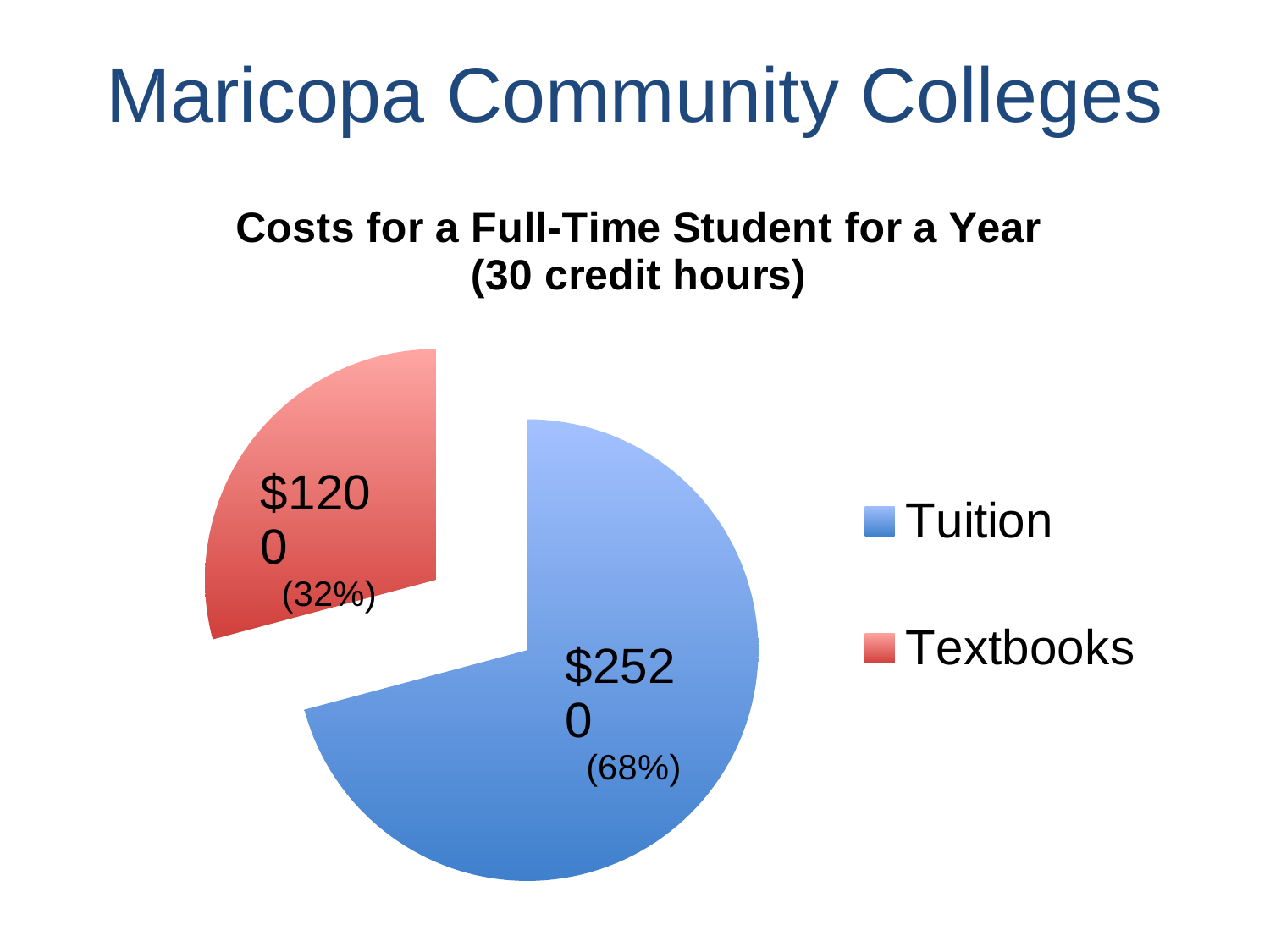
What is the total of the two costs shown in the pie chart? $3720 Which category has the smallest slice of the pie? Textbooks What is the difference between the Tuition cost and the Textbooks cost? $1320 Which category has the largest slice of the pie? Tuition How many categories does the pie chart show? 2 What is the value shown for Tuition? $2520 What share of the pie does Tuition represent? 68% What is the value shown for Textbooks? $1200 What kind of chart is shown on the slide? pie chart Which is larger, the cost of Tuition or the cost of Textbooks? Tuition What is the title of the chart? Costs for a Full-Time Student for a Year (30 credit hours) What share of the pie does Textbooks represent? 32%